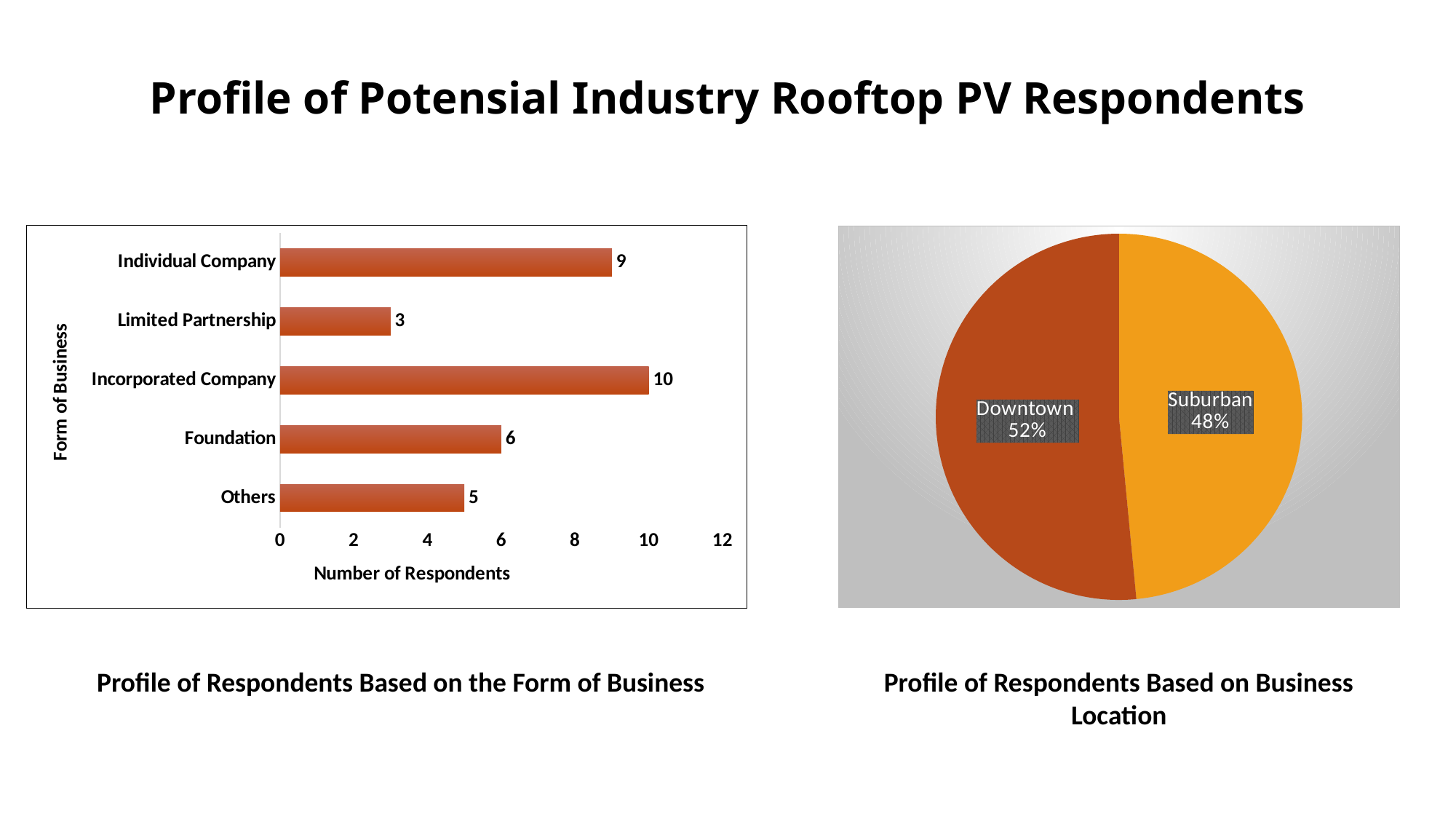
In the bar chart on the left, which form of business has the highest number of respondents? Incorporated Company In the bar chart on the left, which has more respondents, Foundation or Others? Foundation What is the x-axis label of the bar chart on the left? Number of Respondents In the pie chart on the right, what share of respondents are located Downtown? 52% What type of chart is the chart on the left? Bar chart In the bar chart on the left, how many forms of business are shown? 5 In the pie chart on the right, how many slices are there? 2 In the bar chart on the left, how many respondents are Incorporated Companies? 10 In the pie chart on the right, what share of respondents are located in Suburban areas? 48% In the bar chart on the left, how many respondents are Limited Partnerships? 3 In the bar chart on the left, which form of business has the lowest number of respondents? Limited Partnership In the bar chart on the left, what is the difference in respondents between Individual Company and Foundation? 3